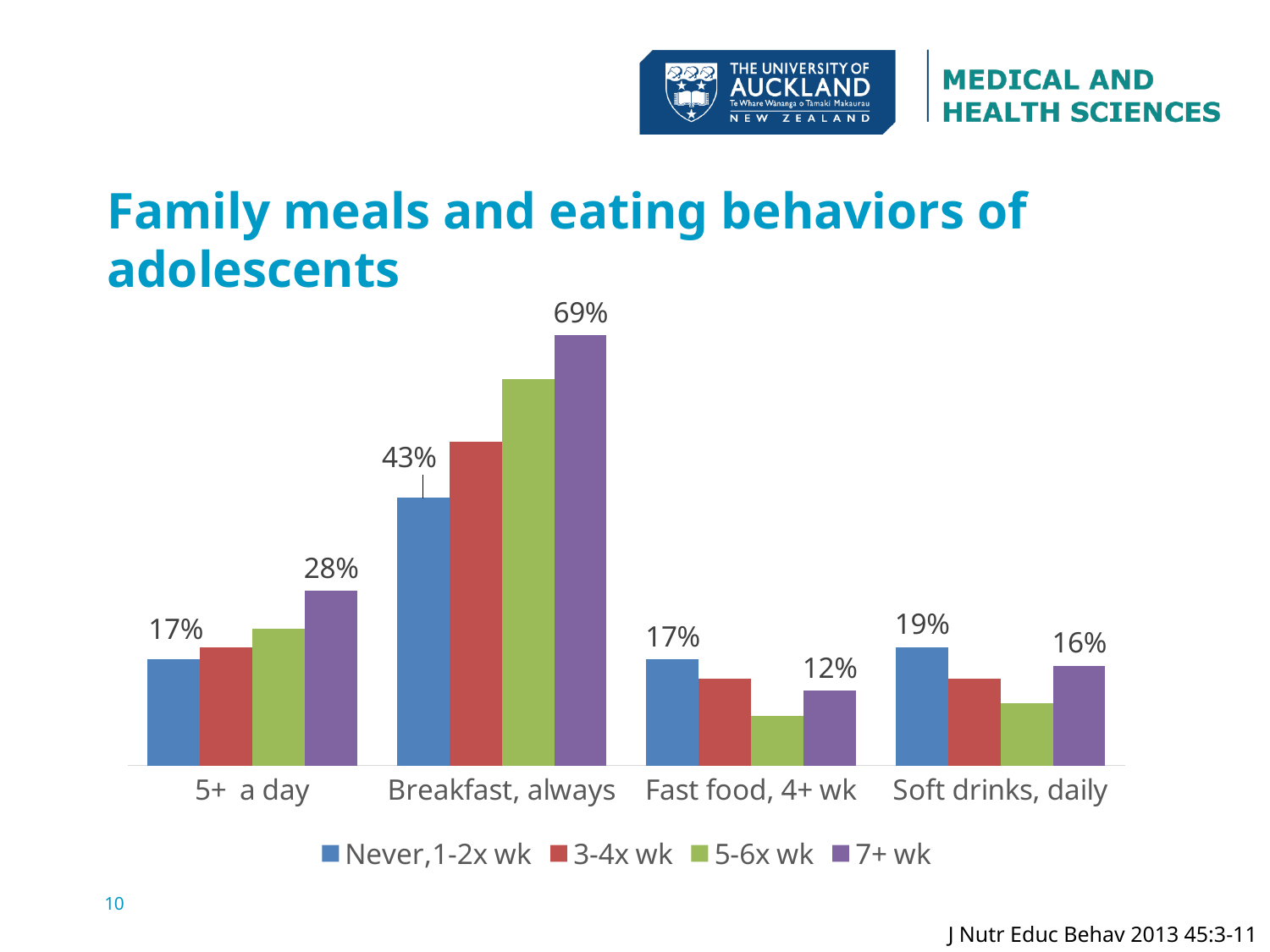
How many categories are shown on the x axis of the chart? 4 What is the value for the Never,1-2x wk series in the Soft drinks, daily category? 19% How many series does the legend list? 4 What is the title of the chart on the slide? Family meals and eating behaviors of adolescents What is the value for the 7+ wk series in the Fast food, 4+ wk category? 12% What is the value for the 7+ wk series in the 5+ a day category? 28% In the Fast food, 4+ wk category, which is larger: the Never,1-2x wk value or the 7+ wk value? Never,1-2x wk What is the value for the 7+ wk series in the Breakfast, always category? 69% What kind of chart is shown on the slide? bar chart Which category has the highest value for the 7+ wk series? Breakfast, always What is the value for the Never,1-2x wk series in the Breakfast, always category? 43% What is the difference between the 7+ wk and Never,1-2x wk values in the Breakfast, always category? 26%